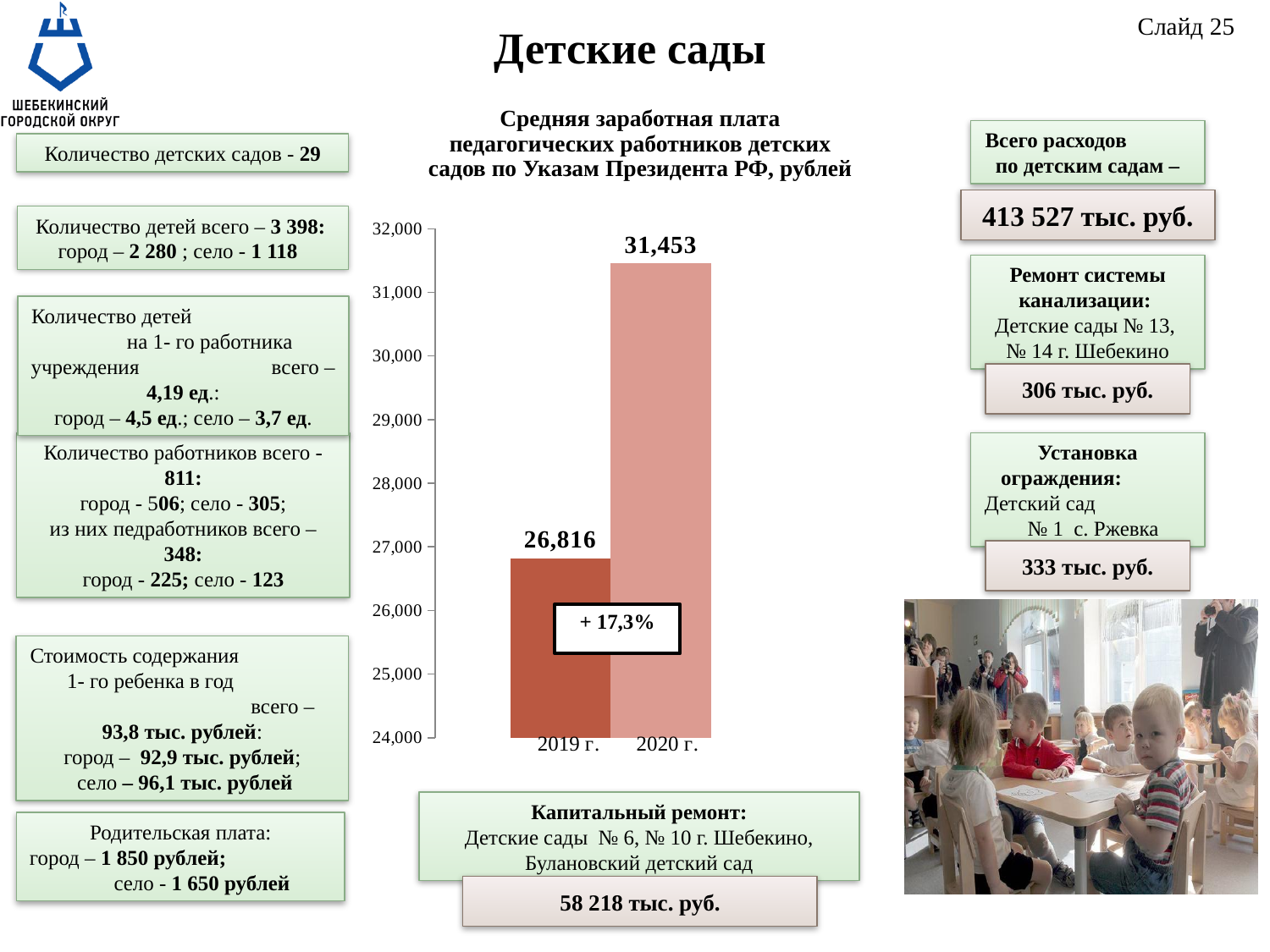
Do the values rise or fall from 2019 г. to 2020 г.? rise Is the value for 2020 г. greater or less than 31,000? greater Which year has the lower bar in the chart? 2019 г. What is the average salary value shown for 2020 г. in the chart? 31,453 What is the difference between the 2020 г. and 2019 г. values in the chart? 4,637 What is the lowest value shown on the chart's vertical axis? 24,000 What is the average salary value shown for 2019 г. in the chart? 26,816 What type of chart is shown on the slide? bar chart How many bars are plotted in the chart? 2 What percentage change is annotated between the two bars in the chart? + 17,3% Which year has the higher bar in the chart? 2020 г. Is the value for 2019 г. greater or less than 27,000? less